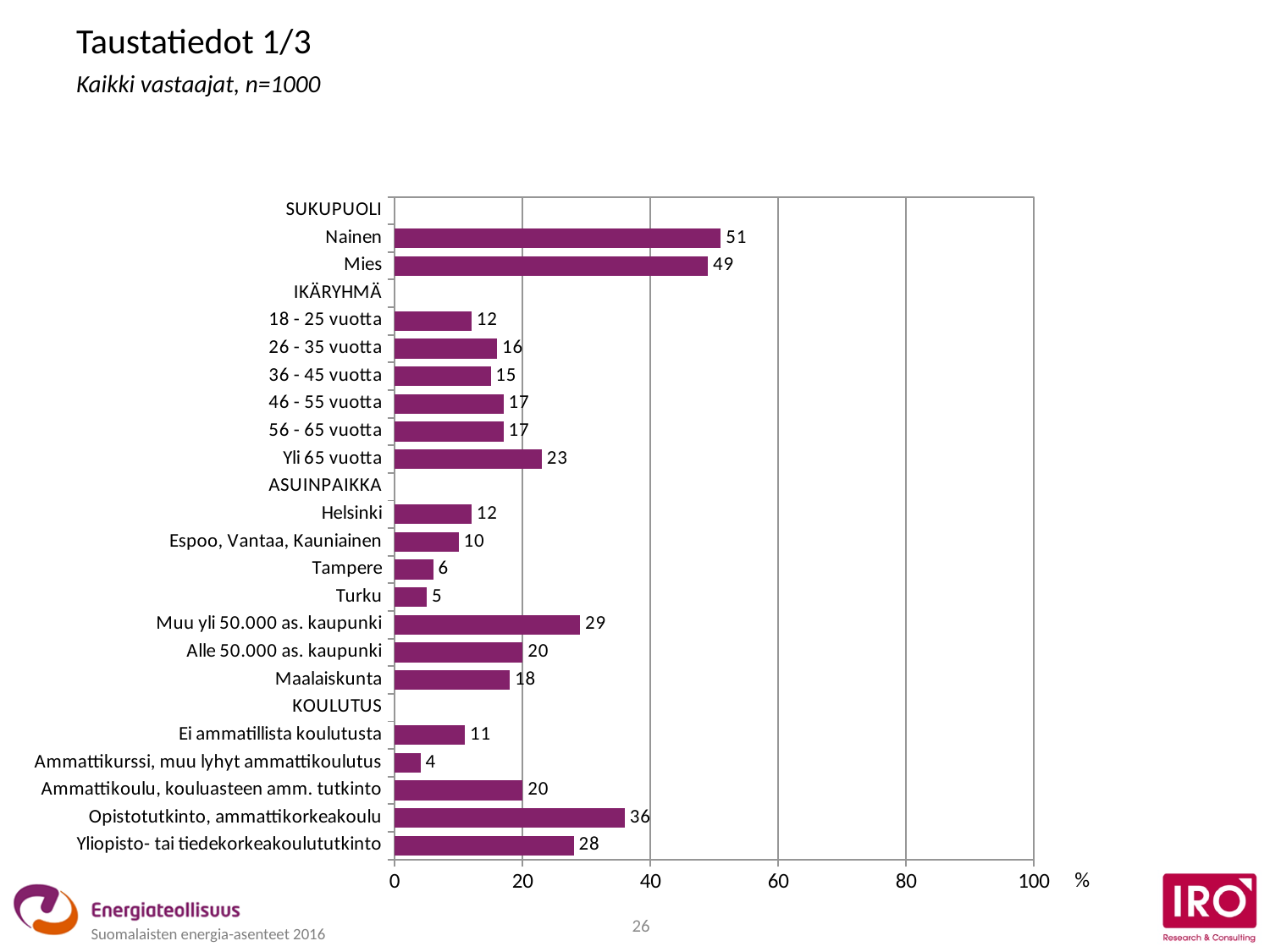
Which residence category (ASUINPAIKKA) has the lowest value? Turku Which education category (KOULUTUS) has the lowest value? Ammattikurssi, muu lyhyt ammattikoulutus What is the value for Nainen? 51 Which age group (IKÄRYHMÄ) has the highest value? Yli 65 vuotta What is the difference between Muu yli 50.000 as. kaupunki and Maalaiskunta? 11 What is the value for Opistotutkinto, ammattikorkeakoulu? 36 How many age groups are shown under IKÄRYHMÄ? 6 Which is larger, the value for Helsinki or the value for Espoo, Vantaa, Kauniainen? Helsinki What is the difference between the values for Nainen and Mies? 2 What type of chart is shown on the slide? Bar chart Is the value for Yliopisto- tai tiedekorkeakoulututkinto greater or less than 20? greater What is the value for Yli 65 vuotta? 23